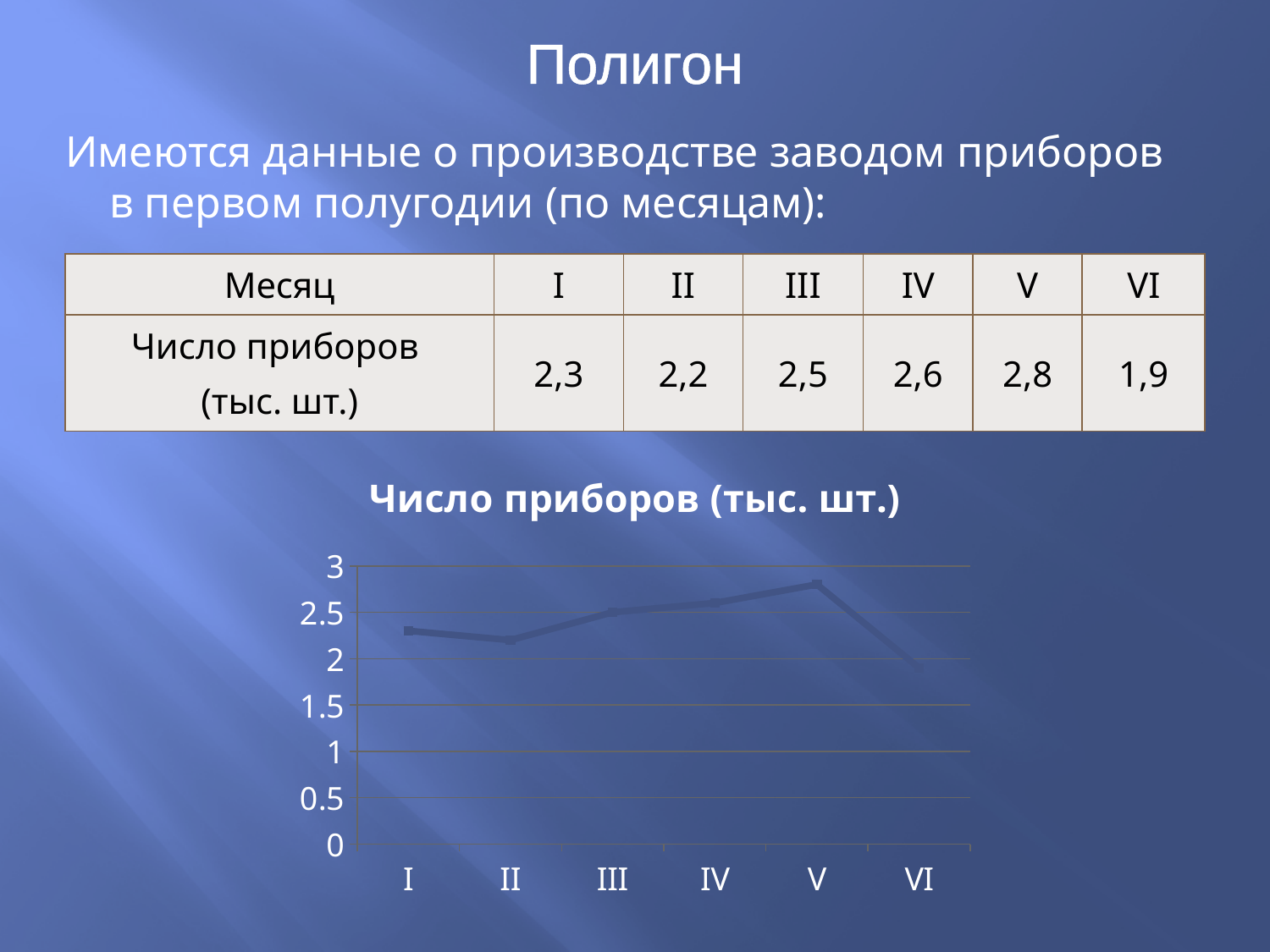
What is the difference between the values for month V and month VI? 0,9 What kind of chart is shown on the slide? line chart Which month has the lowest value? VI Is the value for month VI greater or less than 2? less What is the value for month VI? 1,9 Does the line rise or fall from month V to month VI? fall Which is larger, the value for month III or the value for month II? III What is the title of the chart? Число приборов (тыс. шт.) What is the value for month V? 2,8 What is the value for month II? 2,2 How many months (points) are plotted on the chart? 6 Which month has the highest value? V